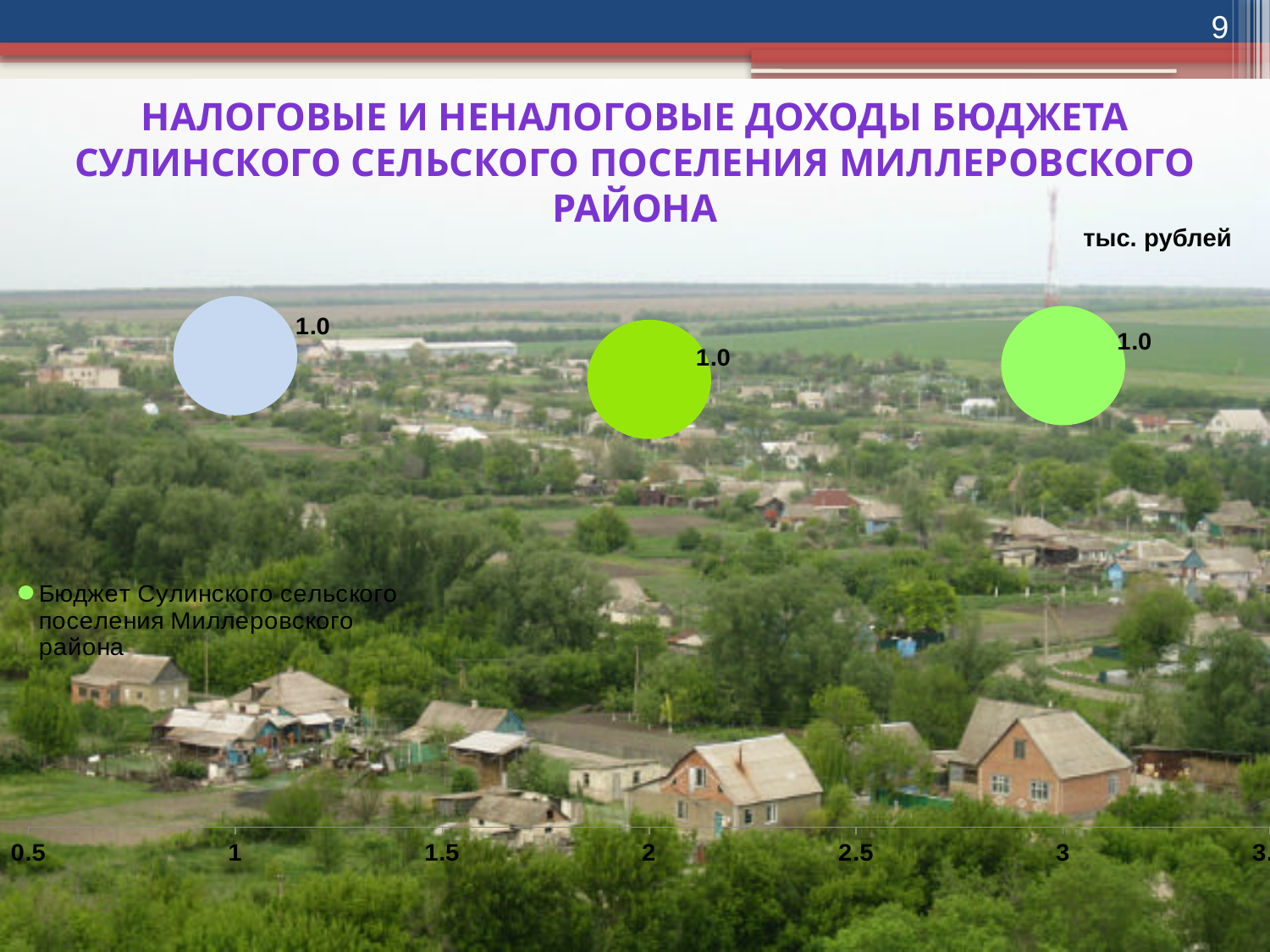
What is the data label on the bubble positioned at x = 2 on the axis? 1.0 Do the labelled bubble values rise, fall or stay the same from left to right along the x axis? stay the same What is the difference between the data labels of the leftmost and rightmost bubbles? 0.0 What series name is shown in the chart legend? Бюджет Сулинского сельского поселения Миллеровского района What is the lowest tick value shown on the x axis? 0.5 How many bubbles (data points) are plotted on the chart? 3 What is the data label on the bubble positioned at x = 1 on the axis? 1.0 How many series does the chart legend list? 1 What kind of chart is shown on the slide? bubble chart What unit of measurement is stated on the chart? тыс. рублей What is the data label on the bubble positioned at x = 3 on the axis? 1.0